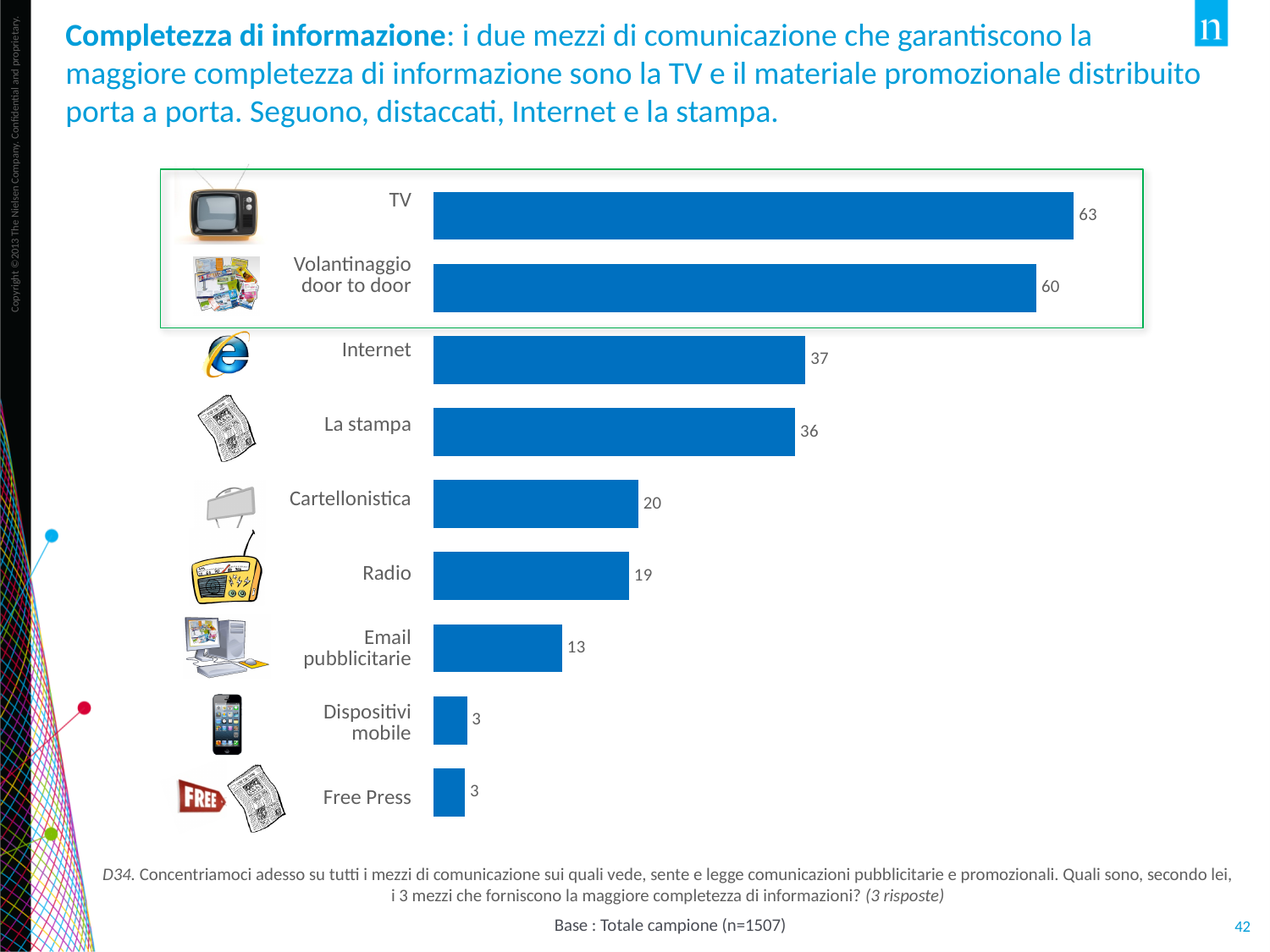
What is the value for Internet? 37 What is the value for Free Press? 3 Which has a larger value, Cartellonistica or Email pubblicitarie? Cartellonistica How many categories are shown in the chart? 9 Which has a larger value, La stampa or Radio? La stampa What is the value for Volantinaggio door to door? 60 What is the difference between the values for TV and Volantinaggio door to door? 3 What is the value for TV? 63 What is the difference between the values for Internet and Cartellonistica? 17 Which category has the highest value? TV What kind of chart is shown on the slide? Bar chart What is the value for Email pubblicitarie? 13